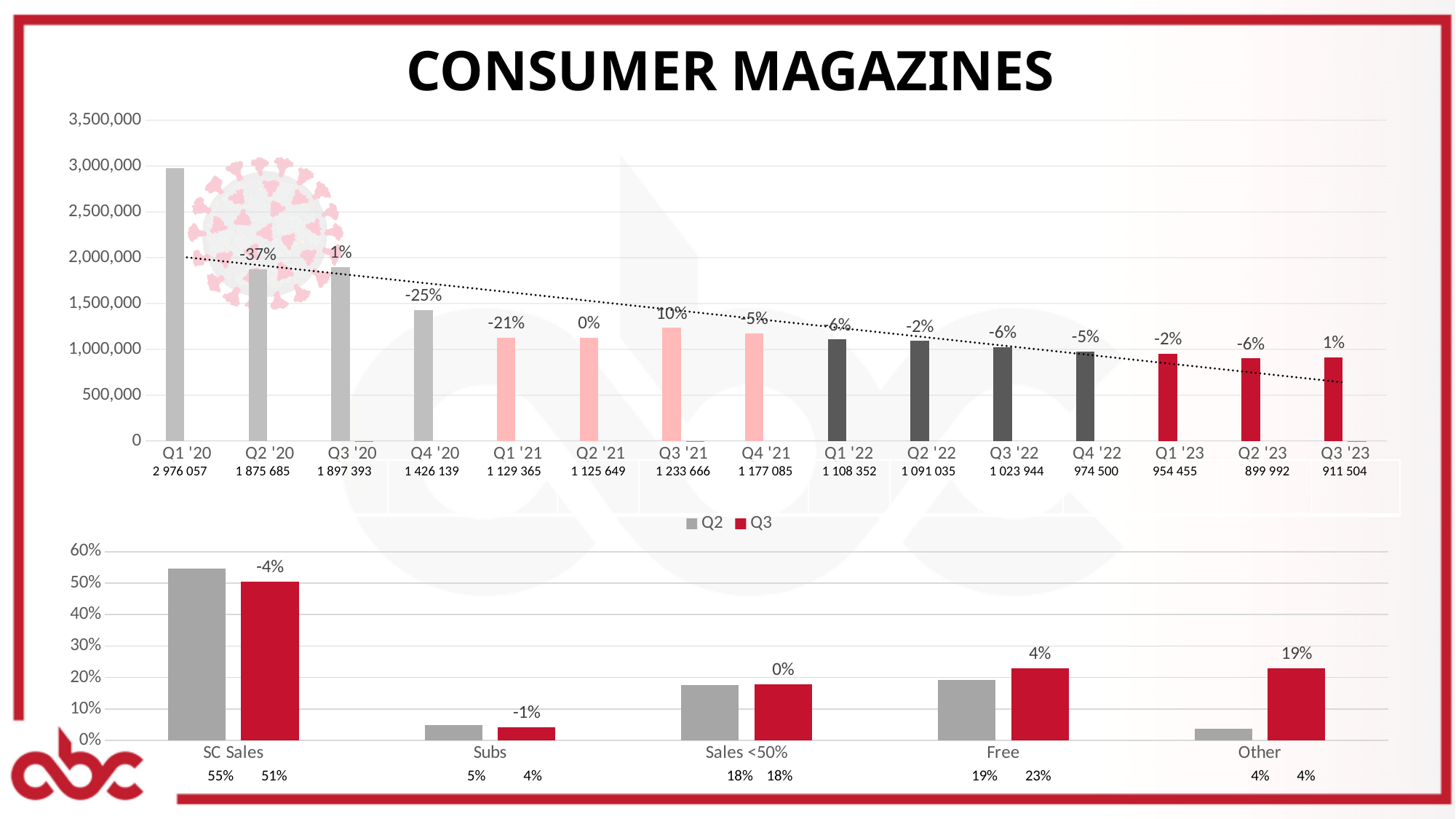
In the bottom chart, how many series does the legend list? 2 In the top chart, what is the value for Q1 '20? 2 976 057 In the top chart, which quarter has the lowest value? Q2 '23 In the bottom chart, is the Q3 value for SC Sales greater or less than 40%? greater In the bottom chart, what is the Q3 value for Free? 23% In the top chart, do the values generally rise or fall from Q1 '20 to Q3 '23? fall In the top chart, what is the difference between the values for Q1 '20 and Q2 '20? 1 100 372 In the bottom chart, which category has the highest Q2 value? SC Sales In the top chart, what is the value for Q3 '23? 911 504 In the top chart, what percentage change is labelled above the Q2 '20 bar? -37% In the top chart, which quarter has the highest value? Q1 '20 In the top chart, how many quarters are plotted? 15